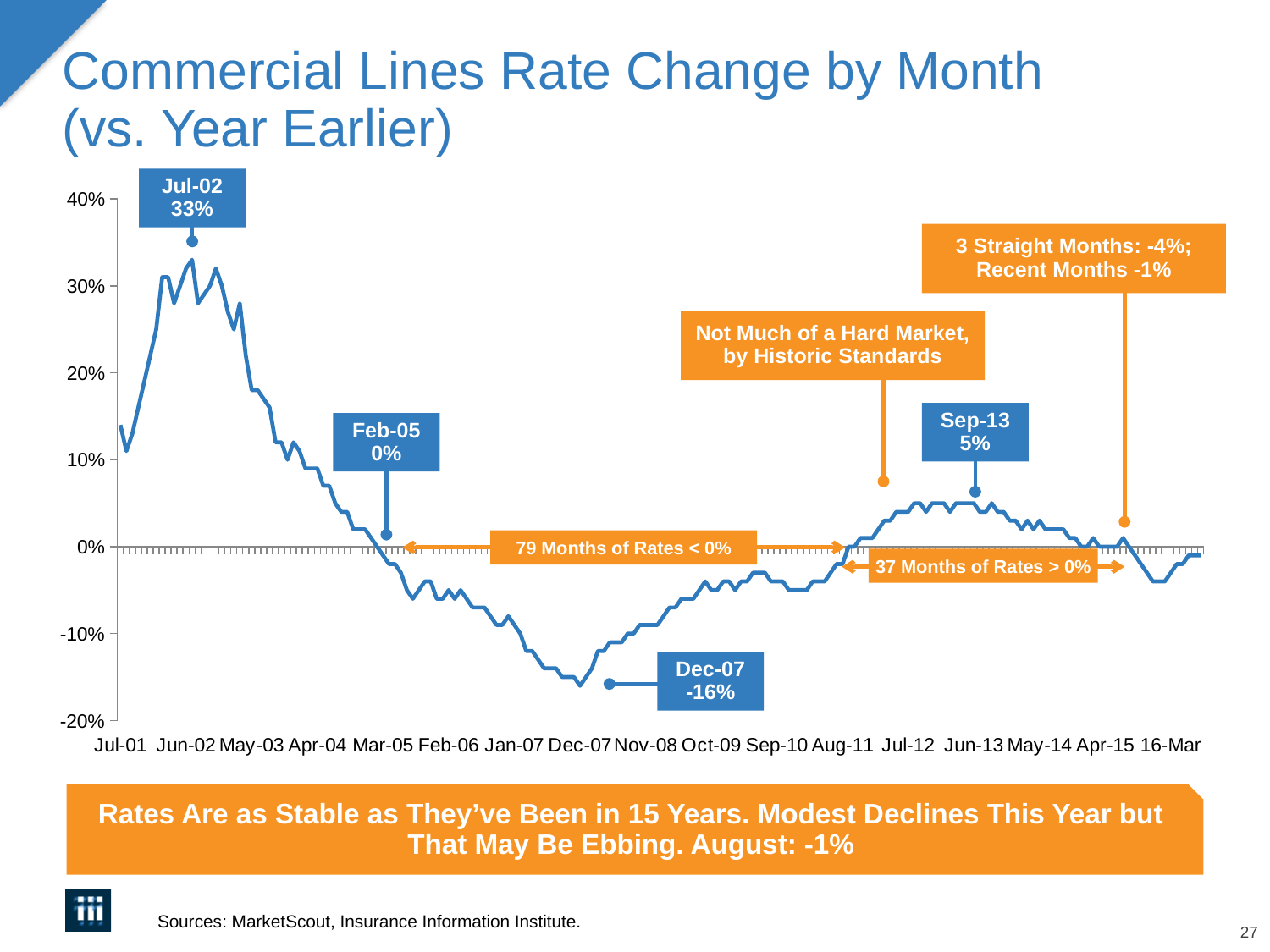
Which is larger, the rate change in Jul-02 or in Sep-13? Jul-02 Which labeled month has the highest rate change? Jul-02 What was the rate change in Dec-07? -16% What was the commercial lines rate change in Jul-02? 33% What kind of chart is shown on the slide? line chart What was the rate change in Sep-13? 5% What was the rate change in Feb-05? 0% What is the difference between the Jul-02 rate change and the Dec-07 rate change? 49 percentage points Which labeled month has the lowest rate change? Dec-07 According to the annotation, how many months had rates below 0%? 79 months Is the rate change in Jan-07 greater or less than 0%? less According to the annotation, how many months had rates above 0%? 37 months